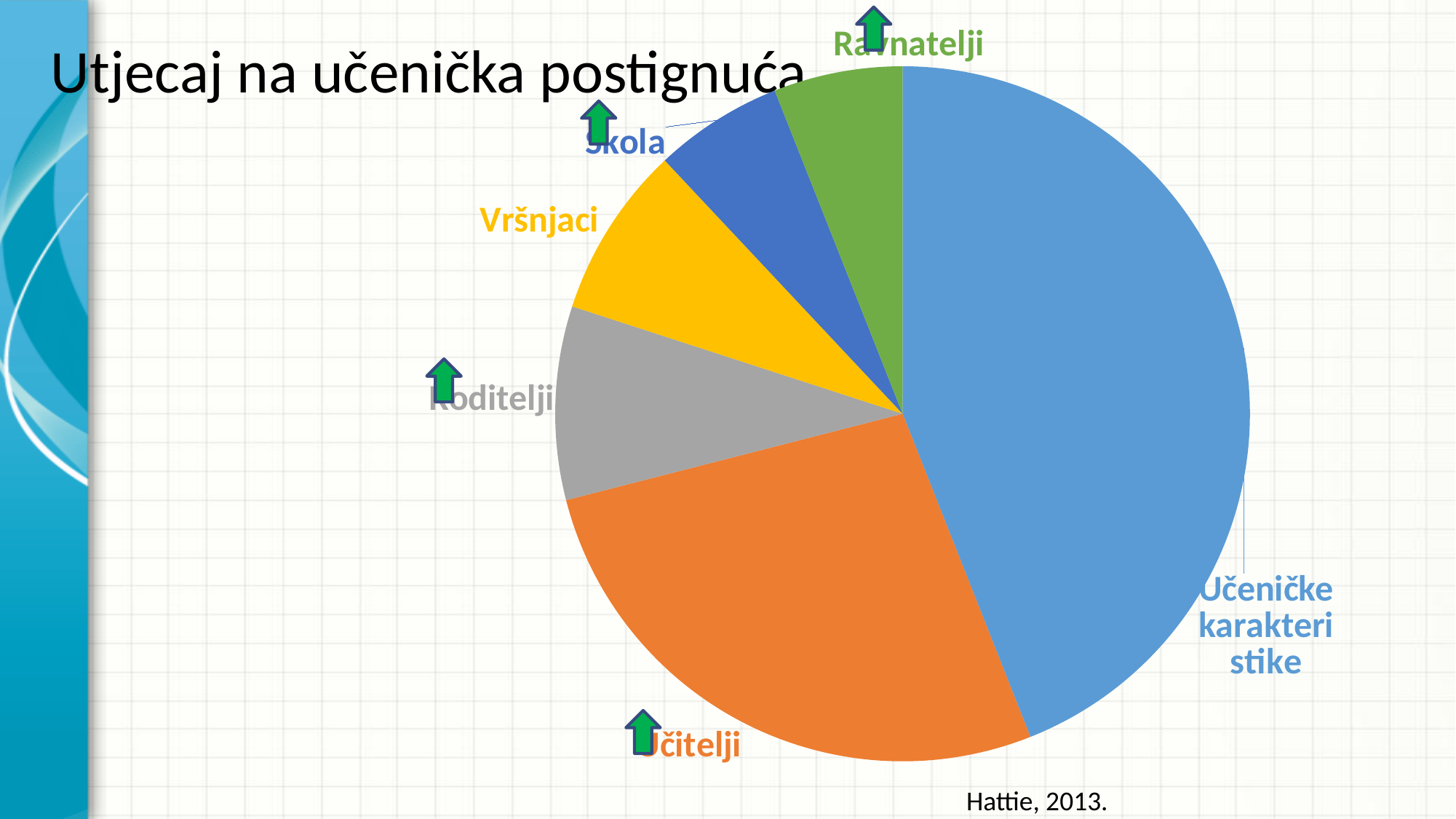
Which category has the largest slice of the pie chart? Učeničke karakteristike Which slice is larger, Učitelji or Roditelji? Učitelji What is the title of the slide containing the pie chart? Utjecaj na učenička postignuća How many slices does the pie chart have? 6 What colour is the Učitelji slice of the pie chart? orange Which slice is larger, Učitelji or Vršnjaci? Učitelji Which category has the second-largest slice of the pie chart? Učitelji Which slice is larger, Vršnjaci or Ravnatelji? Vršnjaci What kind of chart is shown on the slide? pie chart